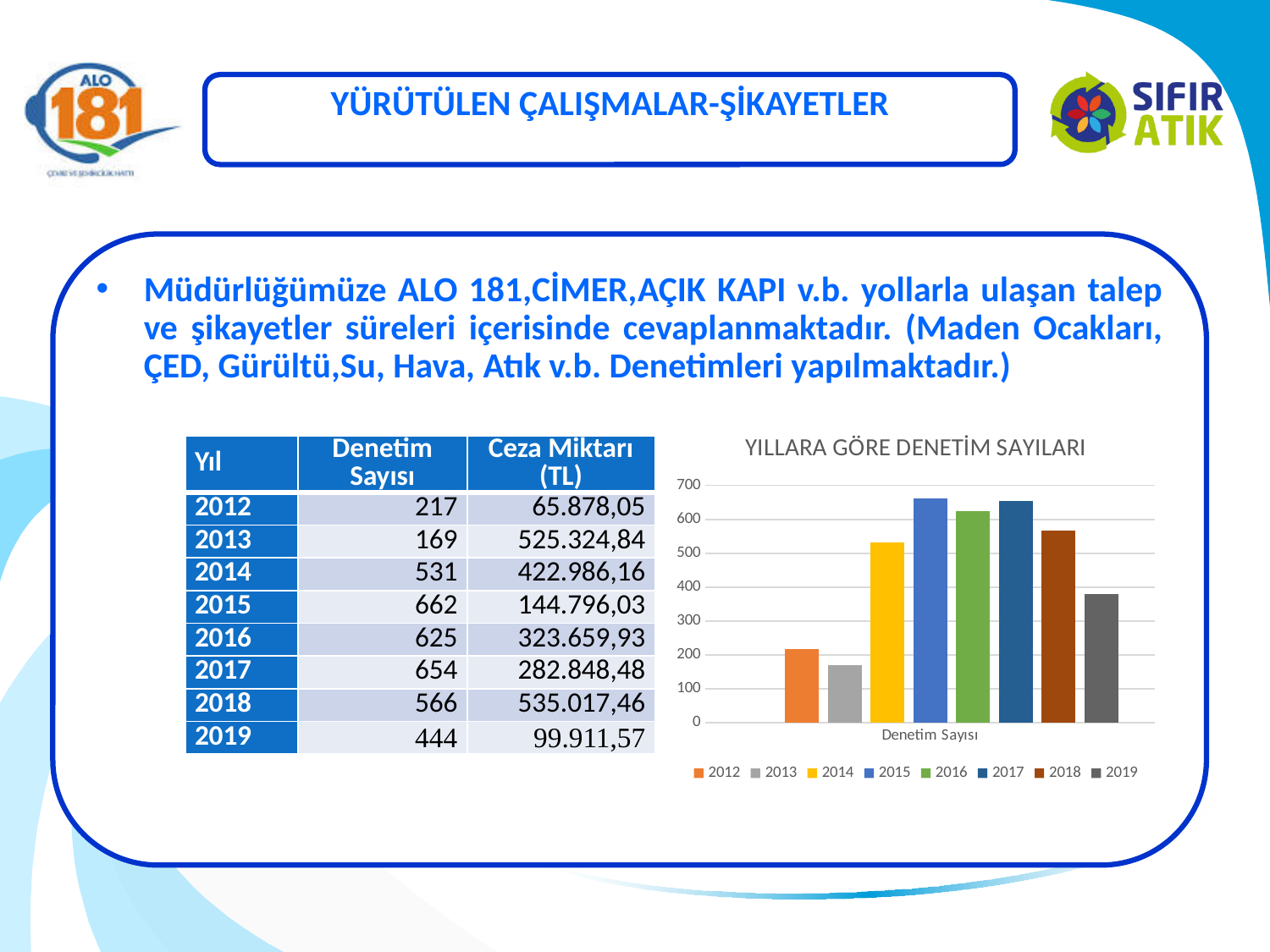
What kind of chart is shown under the title 'YILLARA GÖRE DENETİM SAYILARI'? bar chart How many bars are plotted in the 'YILLARA GÖRE DENETİM SAYILARI' chart? 8 In the 'YILLARA GÖRE DENETİM SAYILARI' chart, is the bar for 2019 greater or less than 400? less Which year has the lowest bar in the 'YILLARA GÖRE DENETİM SAYILARI' chart? 2013 In the 'YILLARA GÖRE DENETİM SAYILARI' chart, is the bar for 2018 greater or less than 500? greater What is the difference between the Denetim Sayısı values for 2017 and 2018 shown on the slide? 88 What is the title of the chart on the slide? YILLARA GÖRE DENETİM SAYILARI In the 'YILLARA GÖRE DENETİM SAYILARI' chart, which bar is taller, 2012 or 2019? 2019 In the 'YILLARA GÖRE DENETİM SAYILARI' chart, which bar is taller, 2014 or 2016? 2016 How many entries does the legend of the 'YILLARA GÖRE DENETİM SAYILARI' chart list? 8 What is the Denetim Sayısı value for 2015 shown on the slide? 662 In the 'YILLARA GÖRE DENETİM SAYILARI' chart, is the bar for 2013 greater or less than 200? less